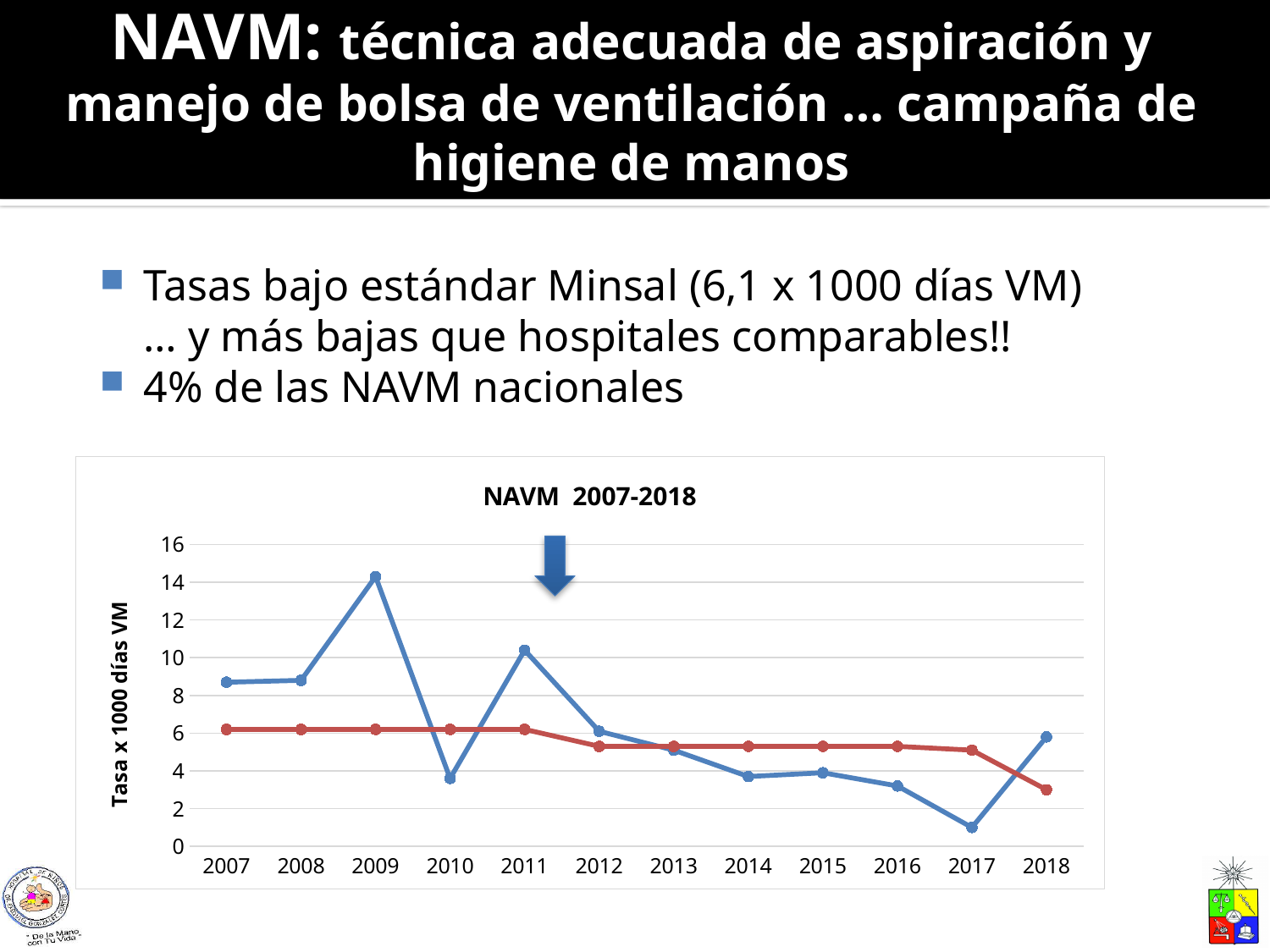
Which is larger for the blue line: the value in 2009 or the value in 2011? 2009 In which year does the blue line reach its lowest value? 2017 How many lines are plotted in the NAVM 2007-2018 chart? 2 What kind of chart is shown on the slide? line chart In which year does the blue line reach its highest value? 2009 Is the value of the blue line in 2017 greater or less than 2? less Is the value of the blue line in 2009 greater or less than 12? greater In 2018, which line has the higher value, the blue line or the red line? blue line How many years are shown on the x axis of the NAVM 2007-2018 chart? 12 Is the value of the blue line in 2011 greater or less than 8? greater Does the red line rise or fall from 2007 to 2018? fall